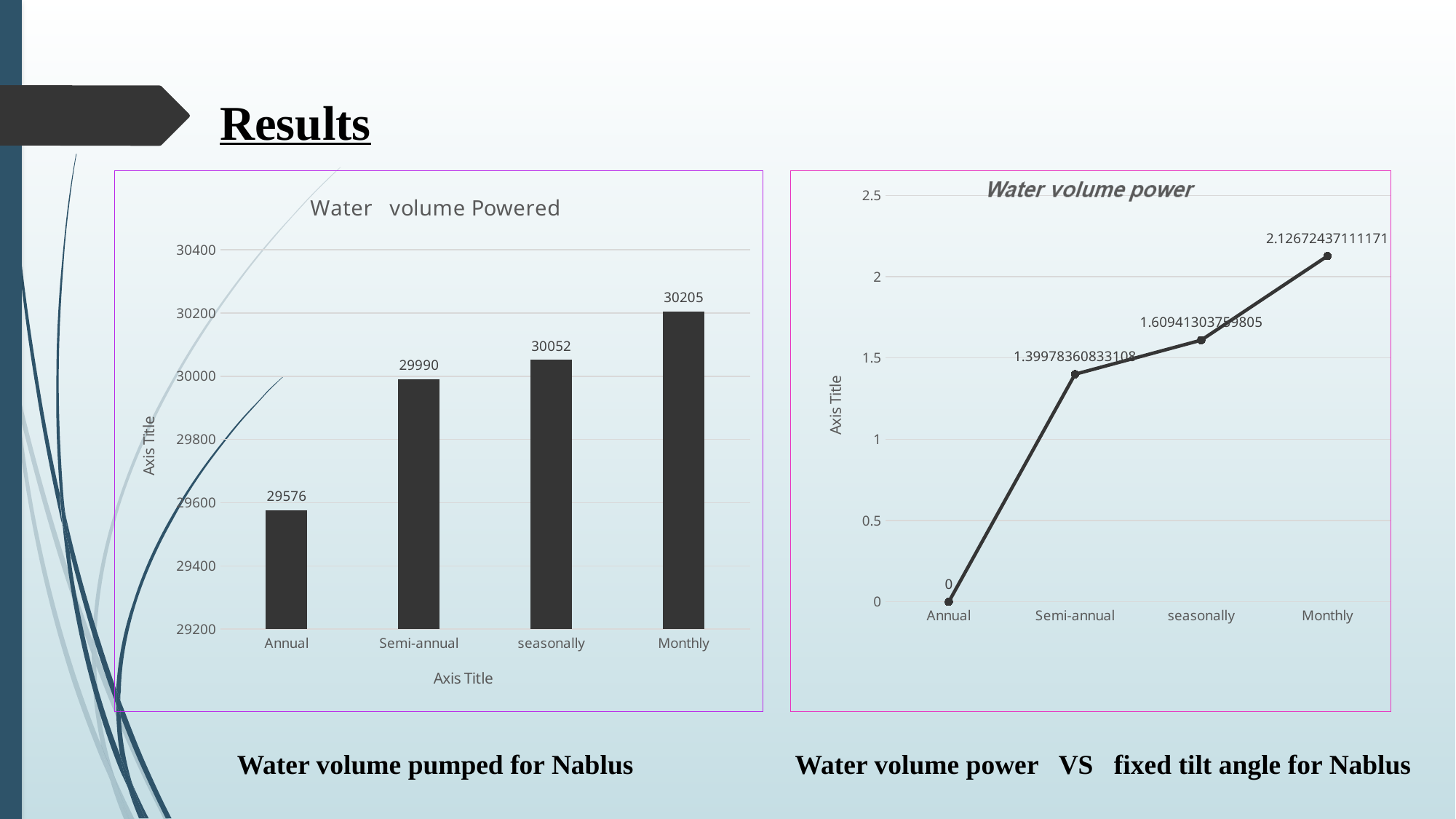
In the 'Water volume power' chart, what is the value for Monthly? 2.12672437111171 In the 'Water volume Powered' chart, what is the value for Annual? 29576 In the 'Water volume power' chart, which is larger, the value for Semi-annual or the value for seasonally? seasonally In the 'Water volume power' chart, do the values rise or fall from Annual to Monthly? Rise In the 'Water volume Powered' chart, what is the difference between the Monthly and Annual values? 629 In the 'Water volume Powered' chart, what is the value for Semi-annual? 29990 In the 'Water volume Powered' chart, which category has the lowest value? Annual What kind of chart is the 'Water volume power' chart? Line chart In the 'Water volume Powered' chart, how many bars are plotted? 4 In the 'Water volume power' chart, what is the value for seasonally? 1.60941303759805 In the 'Water volume Powered' chart, which category has the highest value? Monthly What kind of chart is the 'Water volume Powered' chart? Bar chart